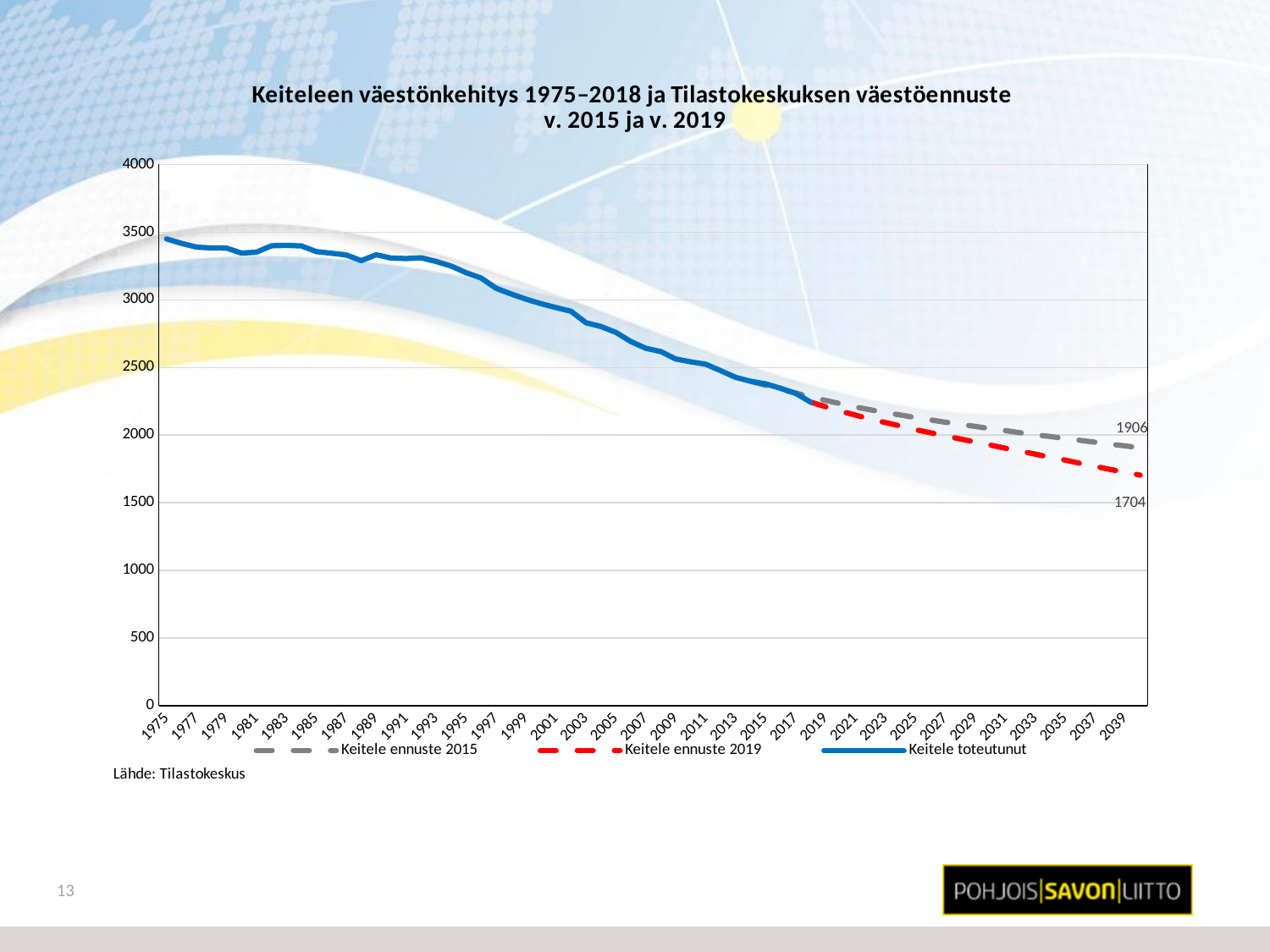
What source is cited below the chart? Tilastokeskus What colour is the Keitele ennuste 2019 line? red What value is labelled at the end of the Keitele ennuste 2019 line? 1704 Does the Keitele toteutunut line rise or fall from 1975 to 2018? fall What is the difference between the labelled end values of the Keitele ennuste 2015 and Keitele ennuste 2019 lines? 202 Which forecast line ends at a higher value, Keitele ennuste 2015 or Keitele ennuste 2019? Keitele ennuste 2015 Is the value for Keitele toteutunut in 1975 greater or less than 3000? greater How many series does the legend list? 3 Is the value for Keitele toteutunut in 2001 greater or less than 2500? greater Is the value for Keitele toteutunut in 2017 greater or less than 2500? less What kind of chart is shown on the slide? line chart What value is labelled at the end of the Keitele ennuste 2015 line? 1906